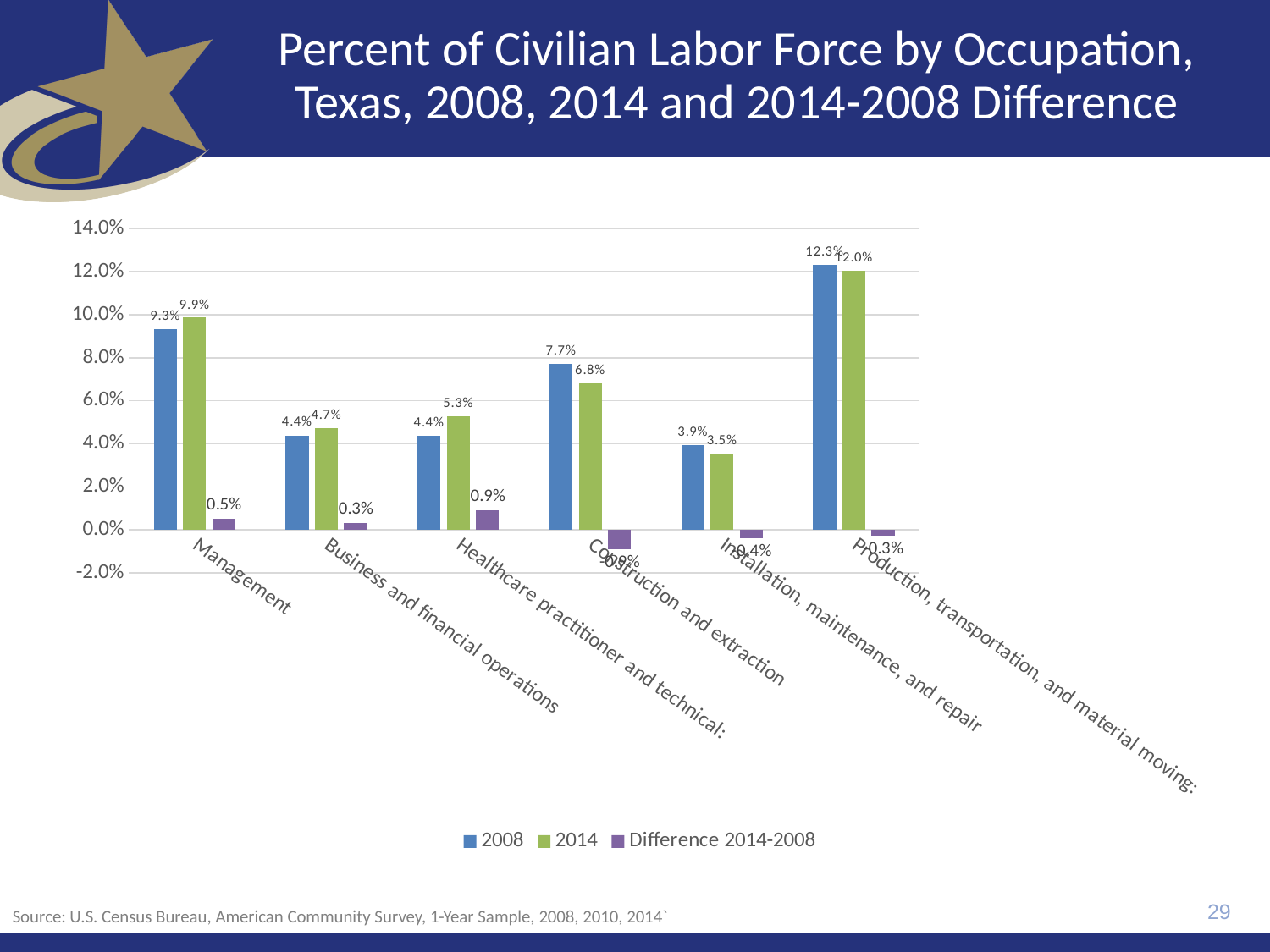
What is the Difference 2014-2008 value for Management? 0.5% Is the 2008 value for Construction and extraction greater or less than 6.0%? greater What is the difference between the 2008 and 2014 values for Construction and extraction? 0.9% Which occupation has the lowest 2014 value? Installation, maintenance, and repair What is the 2014 value for Healthcare practitioner and technical? 5.3% Which is larger for Business and financial operations, the 2008 value or the 2014 value? 2014 What is the 2014 value for Production, transportation, and material moving? 12.0% Which occupation has the highest 2008 value? Production, transportation, and material moving What kind of chart is shown on the slide? bar chart What is the 2008 value for Management? 9.3% How many series does the legend list? 3 How many occupation categories are shown on the x axis? 6